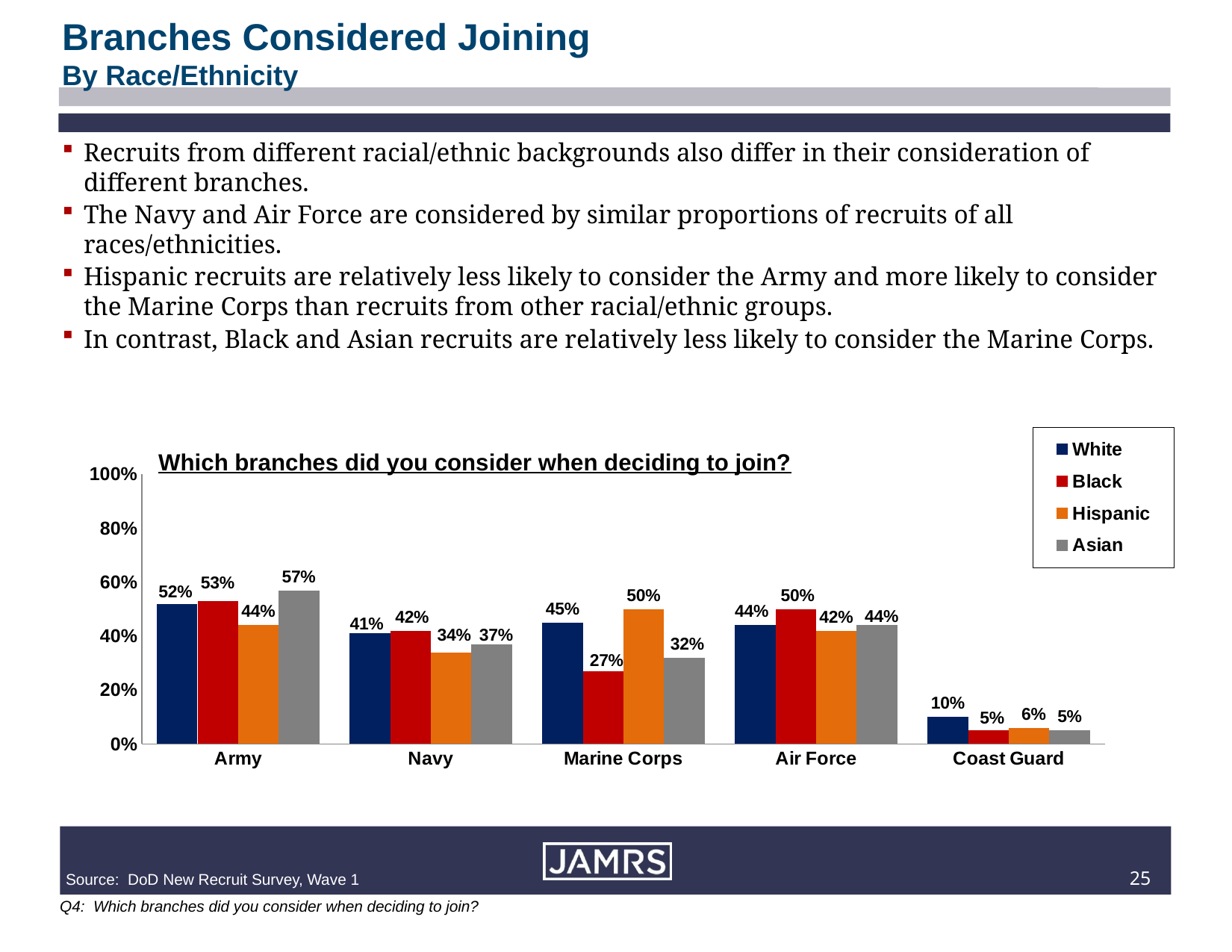
What is the title of the chart? Which branches did you consider when deciding to join? Which racial/ethnic group has the lowest percentage considering the Marine Corps? Black Which colour represents Hispanic recruits in the chart? Orange What percentage of Asian recruits considered the Army? 57% Which is larger: the White percentage for the Navy or the Hispanic percentage for the Navy? White What percentage of White recruits considered the Coast Guard? 10% What is the difference between the Hispanic and Black percentages for the Marine Corps? 23% How many series does the legend list? 4 Which racial/ethnic group has the highest percentage considering the Army? Asian What kind of chart is shown on the slide? Bar chart What percentage of Hispanic recruits considered the Marine Corps? 50% How many branches are shown on the x axis? 5